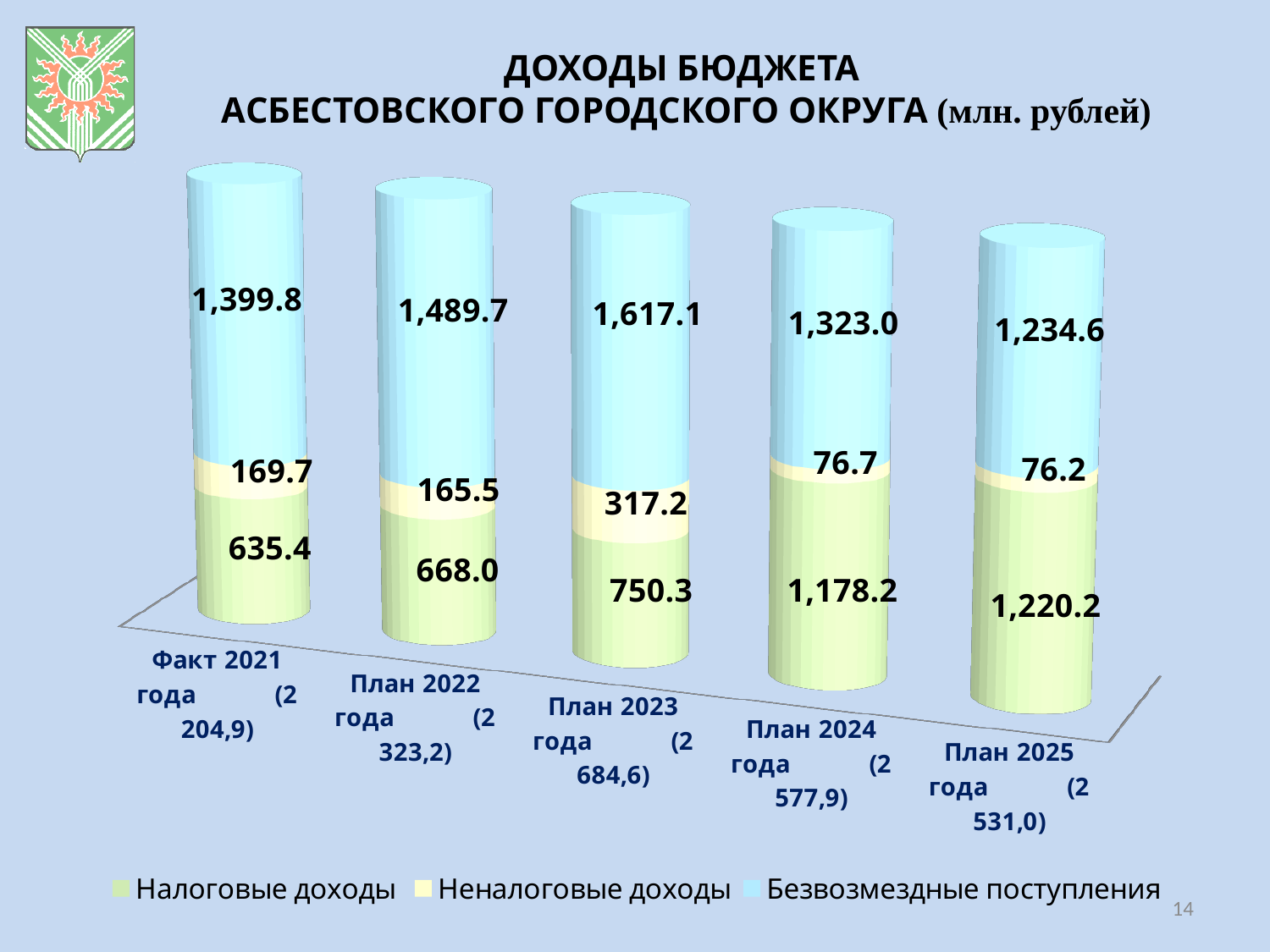
What is the value of Безвозмездные поступления for План 2023 года? 1,617.1 How many categories are shown on the x axis? 5 Which is larger: Неналоговые доходы for План 2023 года or for План 2022 года? План 2023 года What is the total of the stacked bar for План 2024 года? 2,577.9 Which category has the lowest value for Налоговые доходы? Факт 2021 года What kind of chart is shown on the slide? Stacked bar chart Do the values for Налоговые доходы rise or fall from Факт 2021 года to План 2025 года? Rise Which category has the highest value for Безвозмездные поступления? План 2023 года What is the value of Неналоговые доходы for Факт 2021 года? 169.7 What is the value of Налоговые доходы for План 2025 года? 1,220.2 How many series does the legend list? 3 What is the difference between Налоговые доходы for План 2025 года and Факт 2021 года? 584.8